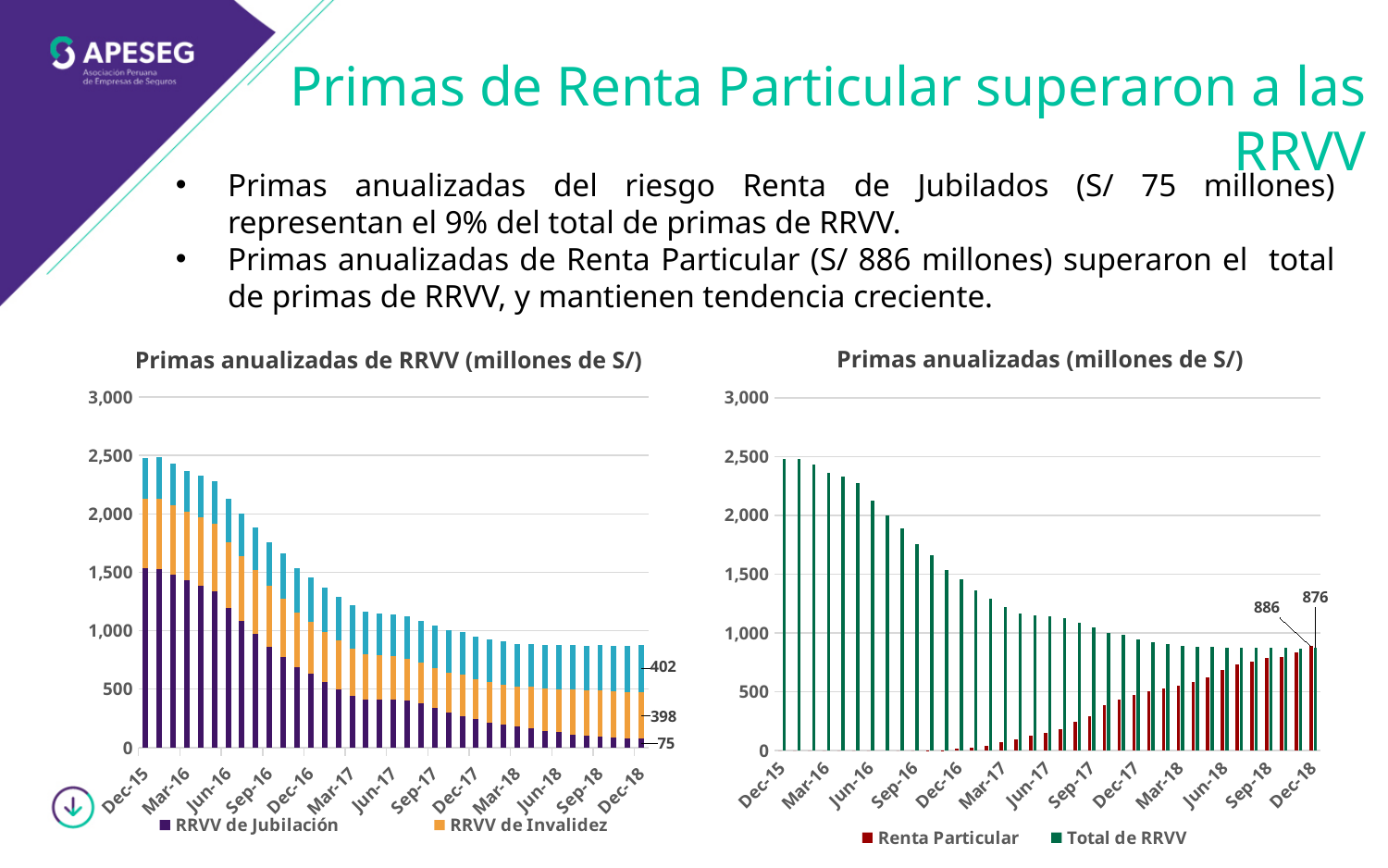
In the chart titled "Primas anualizadas (millones de S/)", how many series does the legend list? 2 In the chart titled "Primas anualizadas (millones de S/)", what is the difference between Renta Particular and Total de RRVV at Dec-18? 10 What kind of chart is the chart titled "Primas anualizadas (millones de S/)"? bar chart In the chart titled "Primas anualizadas (millones de S/)", what is the value for Total de RRVV at Dec-18? 876 In the chart titled "Primas anualizadas (millones de S/)", is the value for Total de RRVV at Dec-15 greater or less than 2,000? greater In the chart titled "Primas anualizadas de RRVV (millones de S/)", what is the value for RRVV de Jubilación at Dec-18? 75 In the chart titled "Primas anualizadas (millones de S/)", which is larger at Dec-18, Renta Particular or Total de RRVV? Renta Particular In the chart titled "Primas anualizadas (millones de S/)", what is the value for Renta Particular at Dec-18? 886 In the chart titled "Primas anualizadas de RRVV (millones de S/)", does the total height of the stacked bars rise or fall from Dec-15 to Dec-18? fall In the chart titled "Primas anualizadas (millones de S/)", does Renta Particular rise or fall from Dec-16 to Dec-18? rise In the chart titled "Primas anualizadas de RRVV (millones de S/)", what is the value for RRVV de Invalidez at Dec-18? 398 In the chart titled "Primas anualizadas (millones de S/)", does Total de RRVV rise or fall from Dec-15 to Dec-18? fall